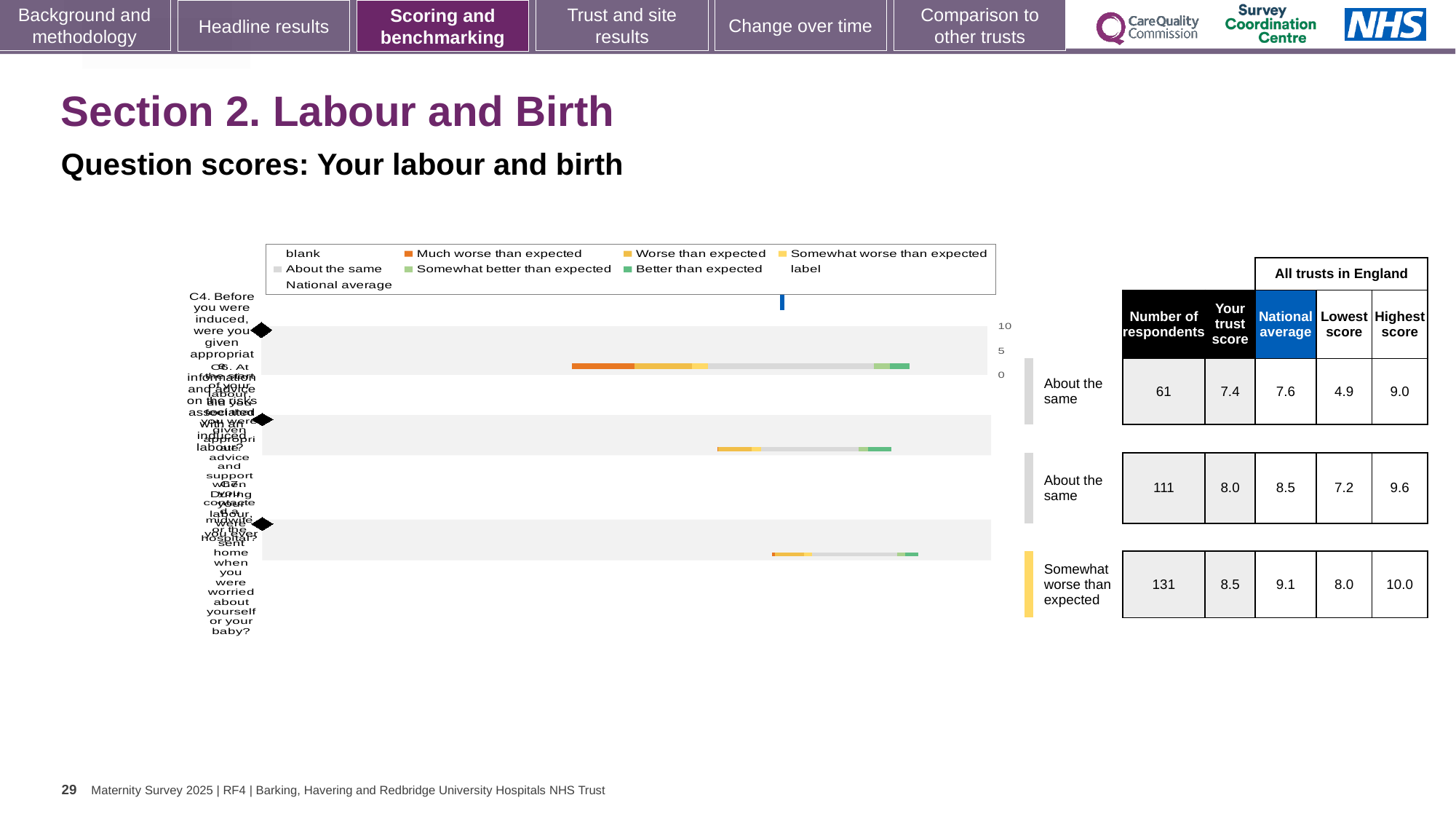
What kind of chart is shown on the slide? bar chart What is the highest score across all trusts in England for the middle row? 9.6 What is the lowest score across all trusts in England for the top row? 4.9 How many question rows (bars) are plotted in the chart? 3 What benchmark category is given for the bottom row? Somewhat worse than expected In the table beside the chart, what is the number of respondents for the top row (C4, before you were induced)? 61 What colour represents 'Much worse than expected' in the chart legend? orange What is the national average for the bottom row of the table? 9.1 For the bottom row, what is the difference between the national average and the trust score? 0.6 For the top row, which is larger: the trust score or the national average? national average What is the 'Your trust score' value for the top row (C4) in the table? 7.4 Which row has the highest 'Your trust score' in the table: top, middle or bottom? bottom